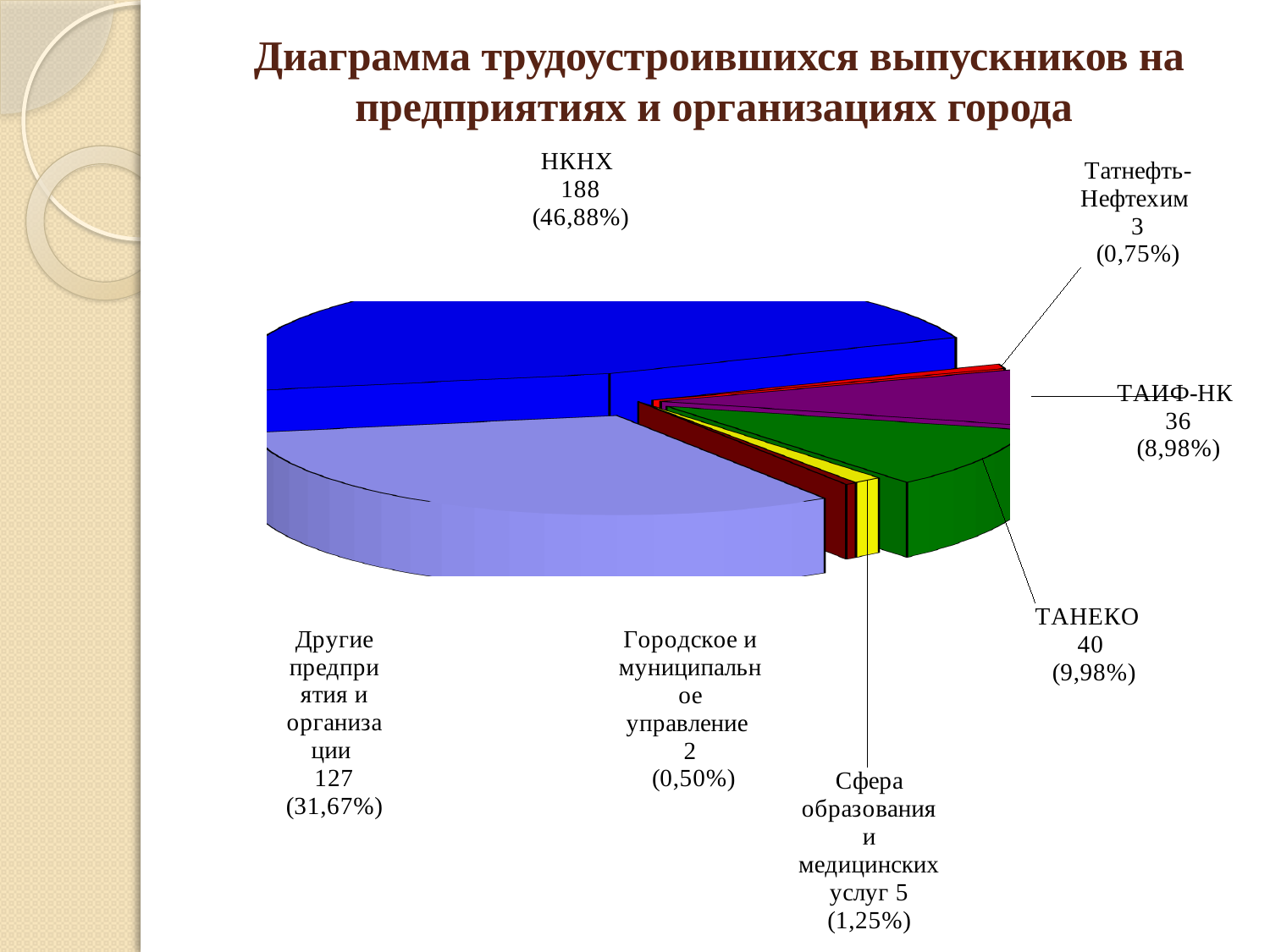
What share of the pie does ТАНЕКО represent? 9,98% Which category has the smallest slice? Городское и муниципальное управление How many slices does the pie chart have? 7 What share of the pie does Другие предприятия и организации represent? 31,67% What is the value for ТАИФ-НК? 36 Which is larger, the value for ТАНЕКО or the value for ТАИФ-НК? ТАНЕКО What is the value for Татнефть-Нефтехим? 3 What is the difference between the values for НКНХ and Другие предприятия и организации? 61 What is the title of the chart? Диаграмма трудоустроившихся выпускников на предприятиях и организациях города What is the value for НКНХ? 188 What type of chart is shown on the slide? Pie chart Which category has the largest slice? НКНХ